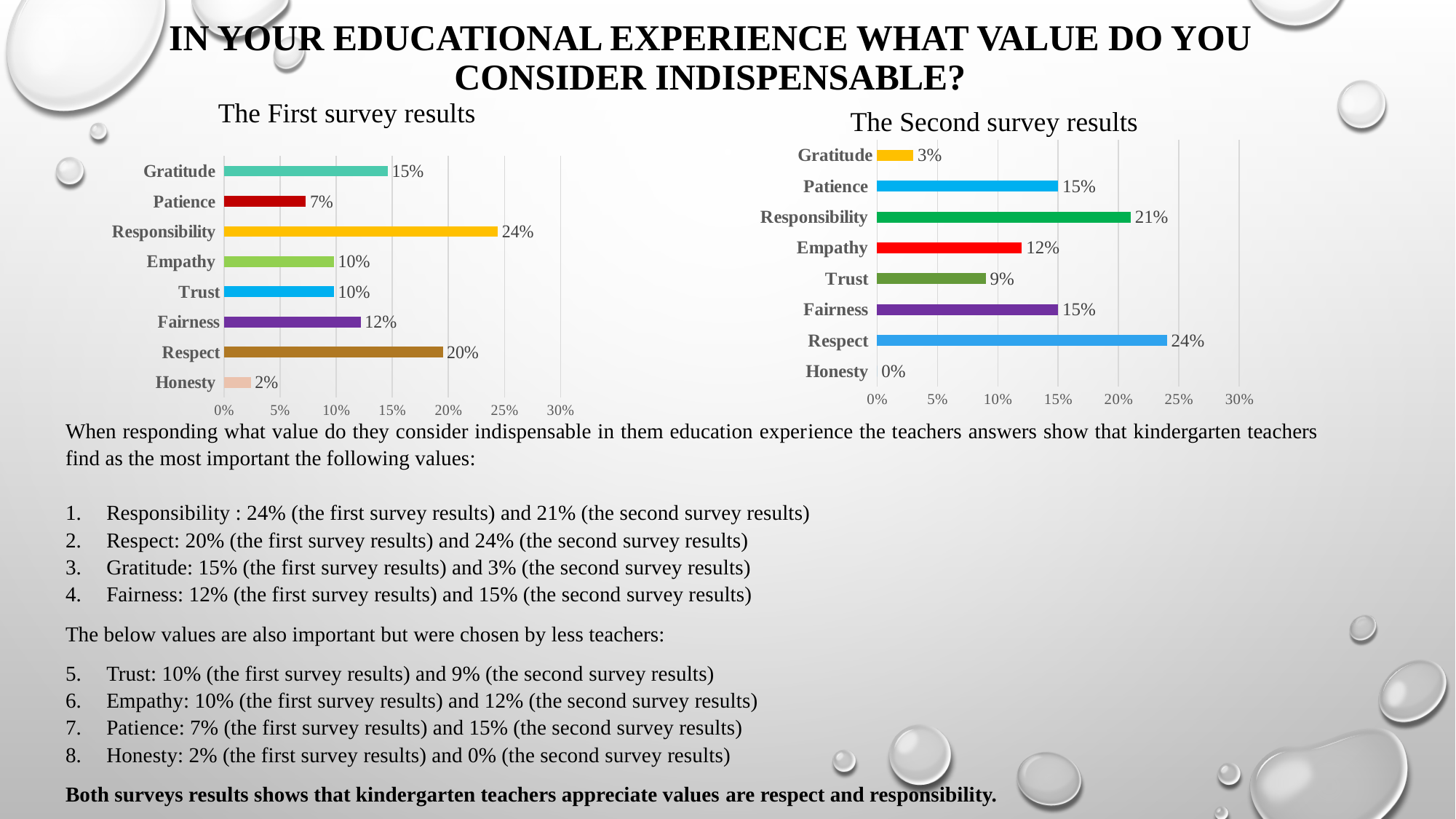
In the chart titled "The First survey results", what is the value for Honesty? 2% What is the title of the chart on the left side of the slide? The First survey results In the chart titled "The Second survey results", which category has the highest value? Respect In the chart titled "The Second survey results", what is the difference between the values for Respect and Responsibility? 3% In the chart titled "The Second survey results", which is larger, the value for Empathy or the value for Trust? Empathy In the chart titled "The Second survey results", which category has the lowest value? Honesty In the chart titled "The First survey results", what is the difference between the values for Respect and Patience? 13% In the chart titled "The First survey results", how many categories are shown? 8 In the chart titled "The First survey results", which category has the highest value? Responsibility In the chart titled "The First survey results", what is the value for Responsibility? 24% In the chart titled "The Second survey results", what is the value for Gratitude? 3% What kind of chart is "The Second survey results"? Bar chart